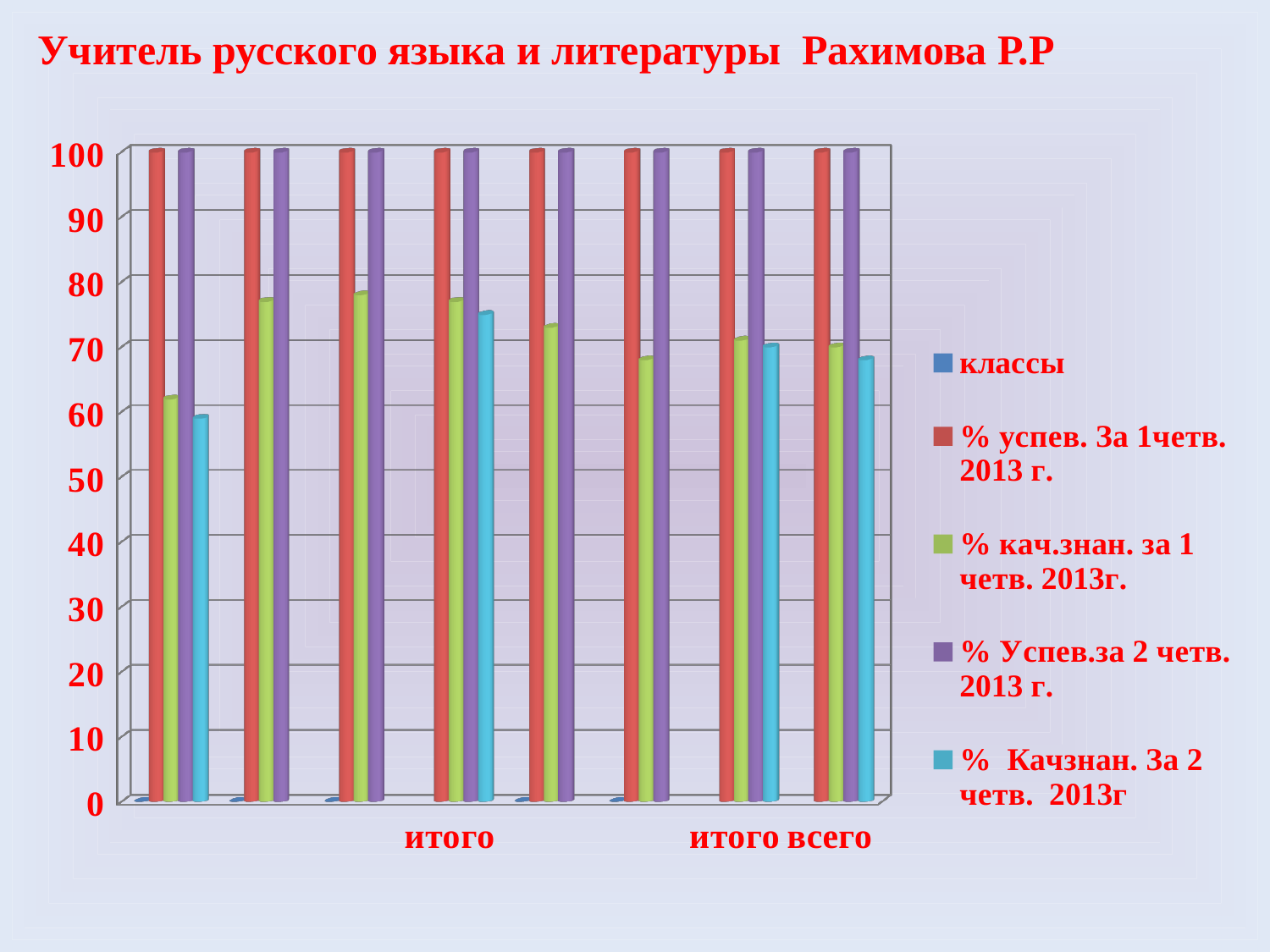
Is the value of "% кач.знан. за 1 четв. 2013г." for "итого всего" greater or less than 80? less What is the value of "% Успев.за 2 четв. 2013 г." for "итого всего"? 100 What is the value of "% успев. За 1четв. 2013 г." for "итого"? 100 Is the value of "% Качзнан. За 2 четв. 2013г" for "итого" greater or less than 70? greater How many groups of bars are plotted along the x axis? 8 What colour represents the "классы" series in the legend? blue How many series does the legend list? 5 Is the value of "% кач.знан. за 1 четв. 2013г." for "итого" greater or less than 70? greater What kind of chart is shown on the slide? bar chart For "итого", which is larger: "% успев. За 1четв. 2013 г." or "% кач.знан. за 1 четв. 2013г."? % успев. За 1четв. 2013 г. What is the title of the slide above the chart? Учитель русского языка и литературы Рахимова Р.Р